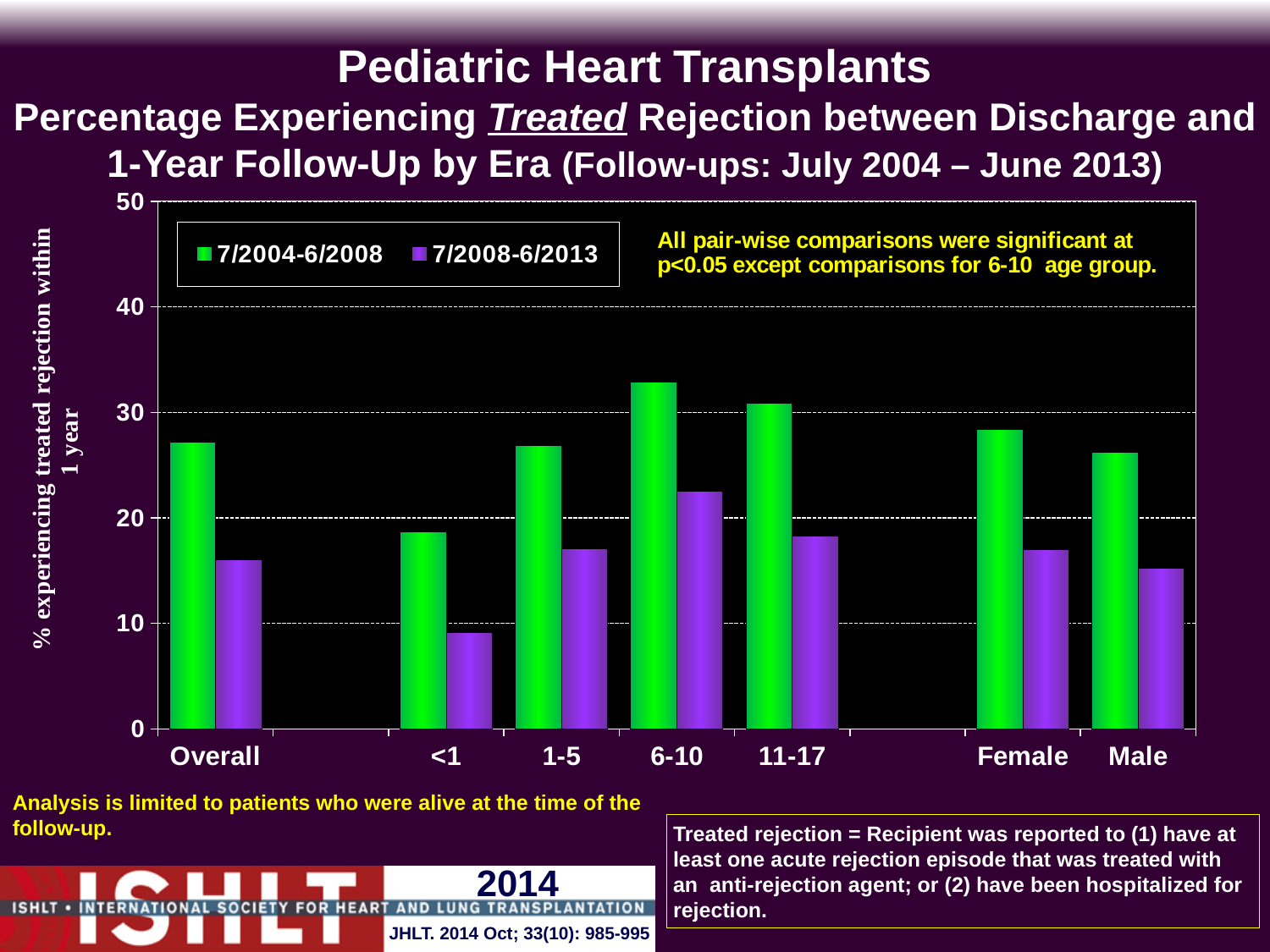
Which category has the highest value for the 7/2004-6/2008 series? 6-10 Which category has the highest value for the 7/2008-6/2013 series? 6-10 Which category has the lowest value for the 7/2004-6/2008 series? <1 How many series does the legend list? 2 How many categories are shown along the x axis? 7 Is the value for 6-10 in the 7/2004-6/2008 series greater or less than 30? greater Is the value for Male in the 7/2008-6/2013 series greater or less than 20? less Is the value for Overall in the 7/2004-6/2008 series greater or less than 20? greater What kind of chart is shown on the slide? bar chart Which category has the lowest value for the 7/2008-6/2013 series? <1 For the Overall category, which series has the larger value, 7/2004-6/2008 or 7/2008-6/2013? 7/2004-6/2008 Which colour represents the 7/2008-6/2013 series? purple